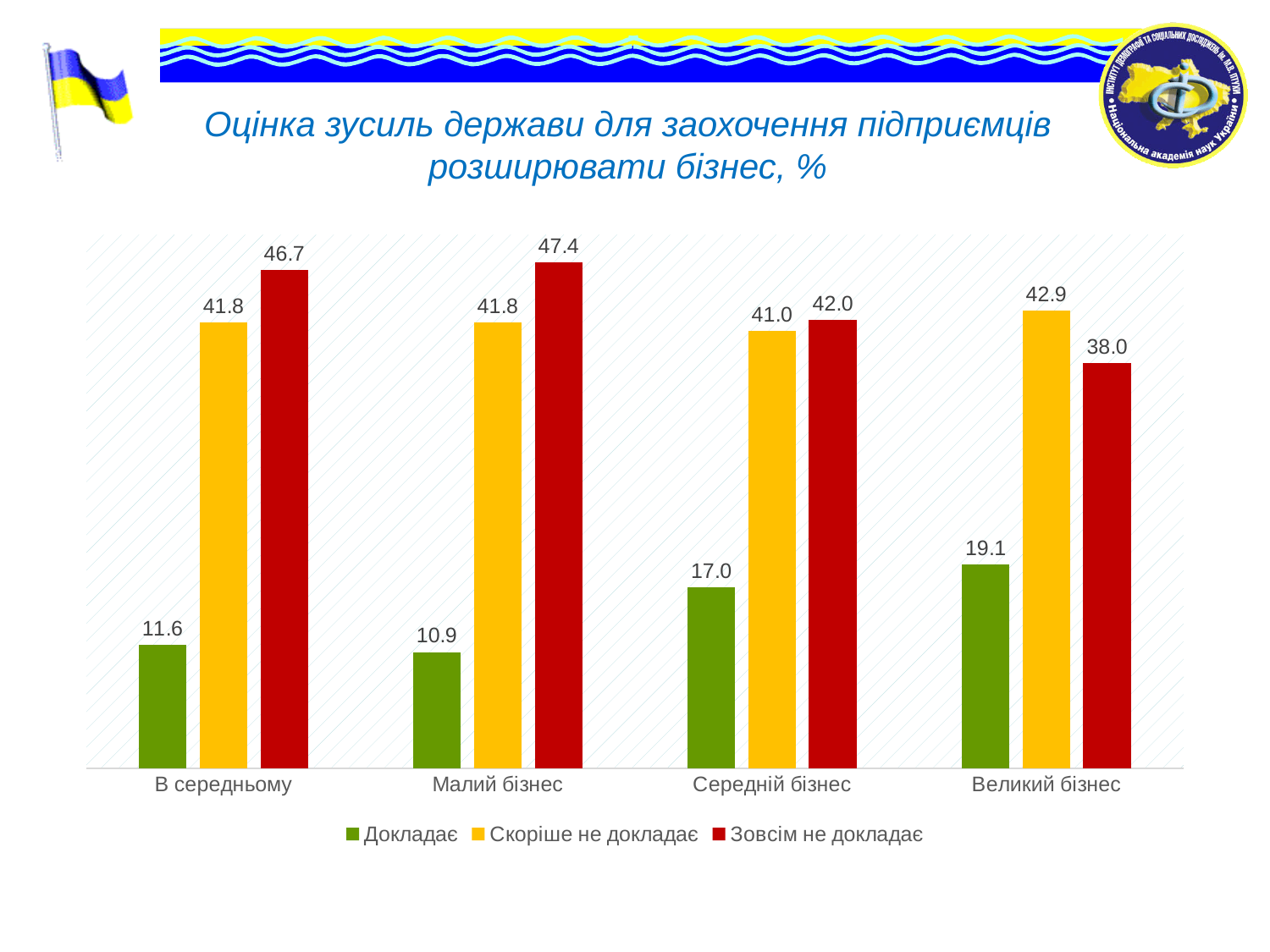
What is the value for "Докладає" in the "Великий бізнес" category? 19.1 What is the value for "Зовсім не докладає" in the "Малий бізнес" category? 47.4 How many categories are shown on the x axis? 4 Which category has the highest value for "Зовсім не докладає"? Малий бізнес In the "Великий бізнес" category, which is larger: "Скоріше не докладає" or "Зовсім не докладає"? Скоріше не докладає Which category has the lowest value for "Докладає"? Малий бізнес Which colour represents the "Докладає" series in the legend? Green How many series does the legend list? 3 What is the value for "Скоріше не докладає" in the "Середній бізнес" category? 41.0 What is the difference between "Зовсім не докладає" and "Докладає" in the "В середньому" category? 35.1 What kind of chart is shown on the slide? Bar chart What is the total of the three values in the "Середній бізнес" category? 100.0